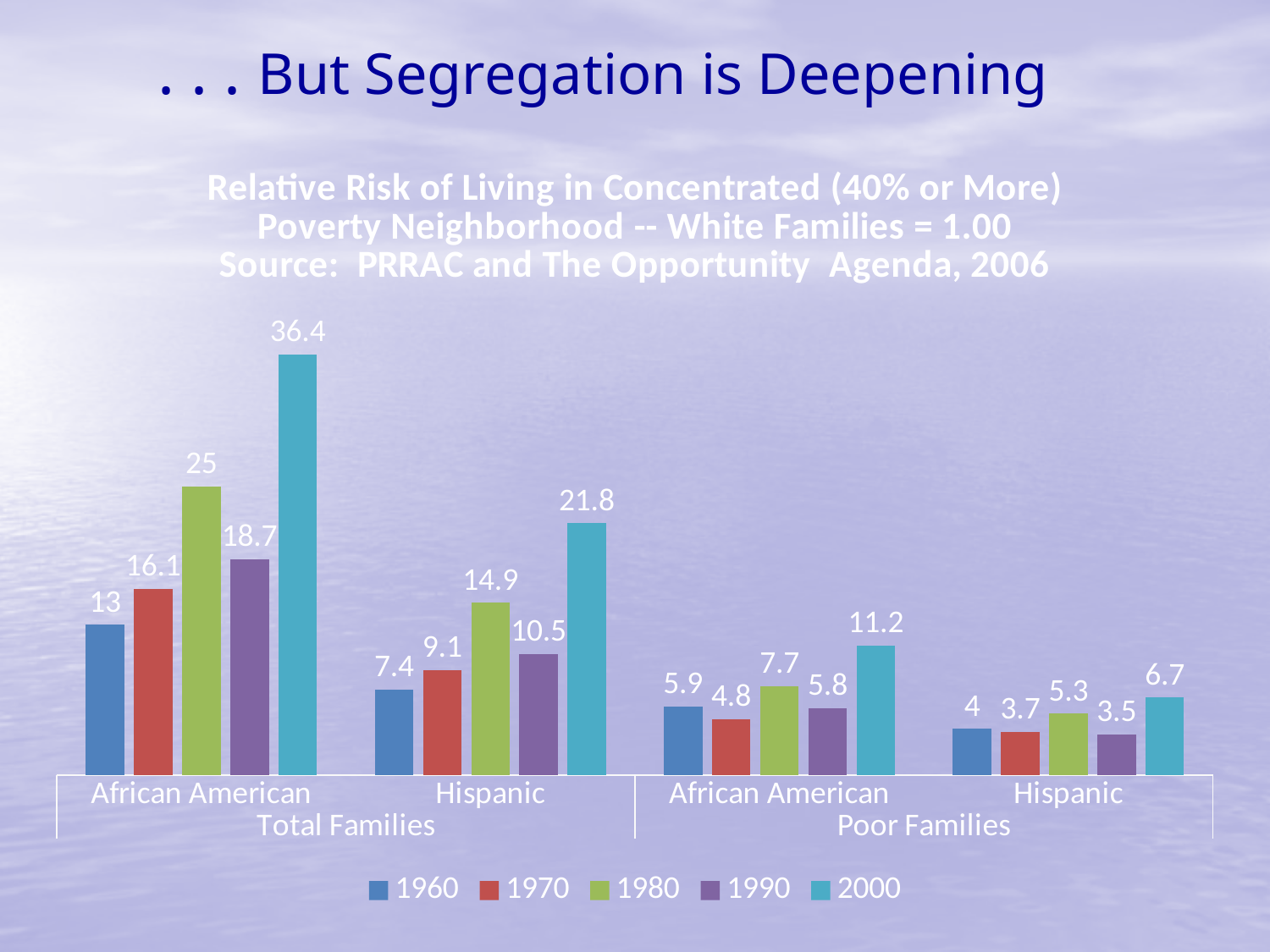
Which year has the highest value for African American Total Families? 2000 What is the difference between the 2000 and 1960 values for Hispanic Total Families? 14.4 What is the value for African American Poor Families in 1970? 4.8 Which is larger for African American Poor Families: the 1980 value or the 1990 value? 1980 What kind of chart is shown on the slide? Bar chart What is the value for Hispanic Poor Families in 1990? 3.5 What is the value for African American Total Families in 2000? 36.4 What is the source cited in the chart title? PRRAC and The Opportunity Agenda, 2006 How many series does the legend list? 5 What is the value for Hispanic Total Families in 1980? 14.9 Which year has the lowest value for Hispanic Poor Families? 1990 Do the values for Hispanic Total Families rise or fall from 1960 to 2000? Rise